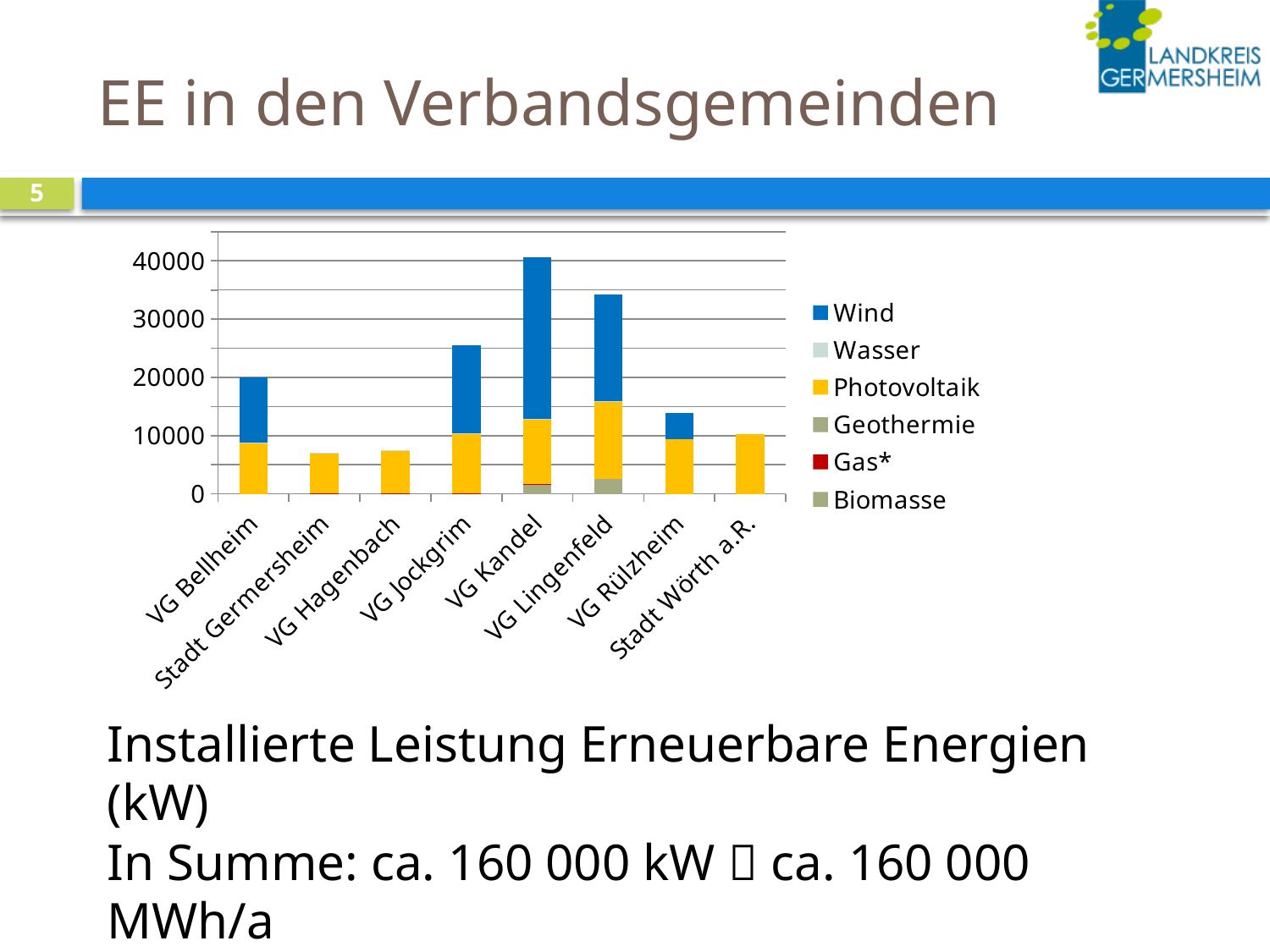
How many categories (municipalities) are shown on the x axis of the chart? 8 Which has the larger total installed capacity, VG Kandel or VG Lingenfeld? VG Kandel Is the total value for VG Jockgrim greater or less than 20000? greater Is the total value for Stadt Germersheim greater or less than 10000? less How many series does the chart's legend list? 6 Is the total value for VG Kandel greater or less than 30000? greater Which municipality has the highest total installed capacity in the chart? VG Kandel What kind of chart is shown on the slide? Stacked bar chart Which has the larger total installed capacity, VG Jockgrim or VG Rülzheim? VG Jockgrim Which series is shown in yellow in the chart's legend? Photovoltaik Which series is shown in blue in the chart's legend? Wind